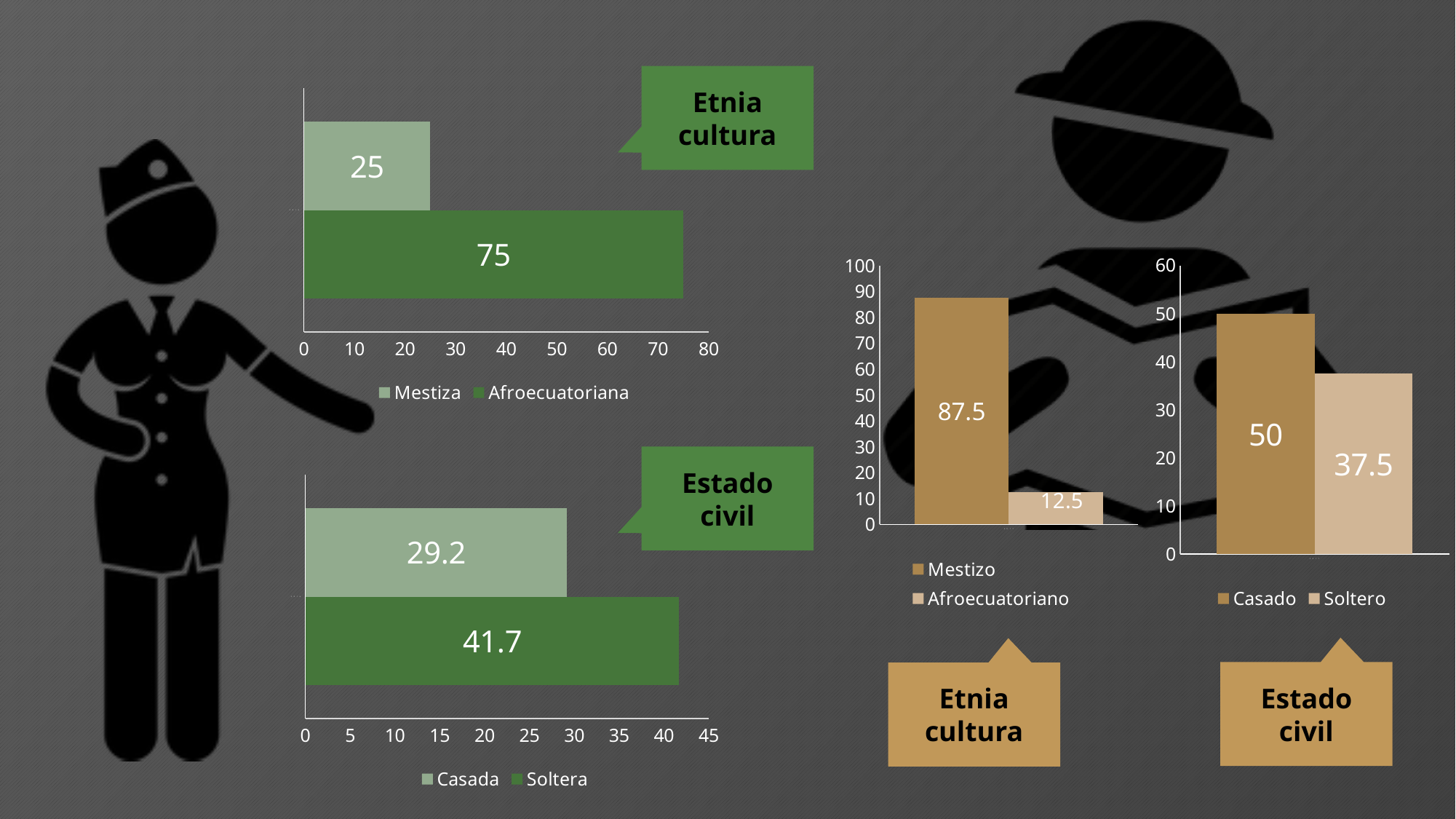
In the brown vertical bar chart labelled Etnia cultura on the right, what is the value for Mestizo? 87.5 In the top-left green bar chart (Etnia cultura), what is the difference between the Afroecuatoriana and Mestiza values? 50 What type of chart is the top-left chart labelled Etnia cultura? Bar chart In the top-left green bar chart (Etnia cultura), what is the value for Mestiza? 25 In the top-left green bar chart (Etnia cultura), what is the value for Afroecuatoriana? 75 In the brown vertical bar chart labelled Etnia cultura on the right, what is the value for Afroecuatoriano? 12.5 In the brown vertical bar chart labelled Estado civil on the right, what is the value for Soltero? 37.5 How many series does the legend of the bottom-left green chart (Estado civil) list? 2 In the bottom-left green bar chart (Estado civil), which category has the lower value? Casada In the bottom-left green bar chart (Estado civil), what is the difference between Soltera and Casada? 12.5 In the bottom-left green bar chart (Estado civil), what is the value for Soltera? 41.7 In the brown vertical bar chart labelled Estado civil on the right, which is larger, Casado or Soltero? Casado